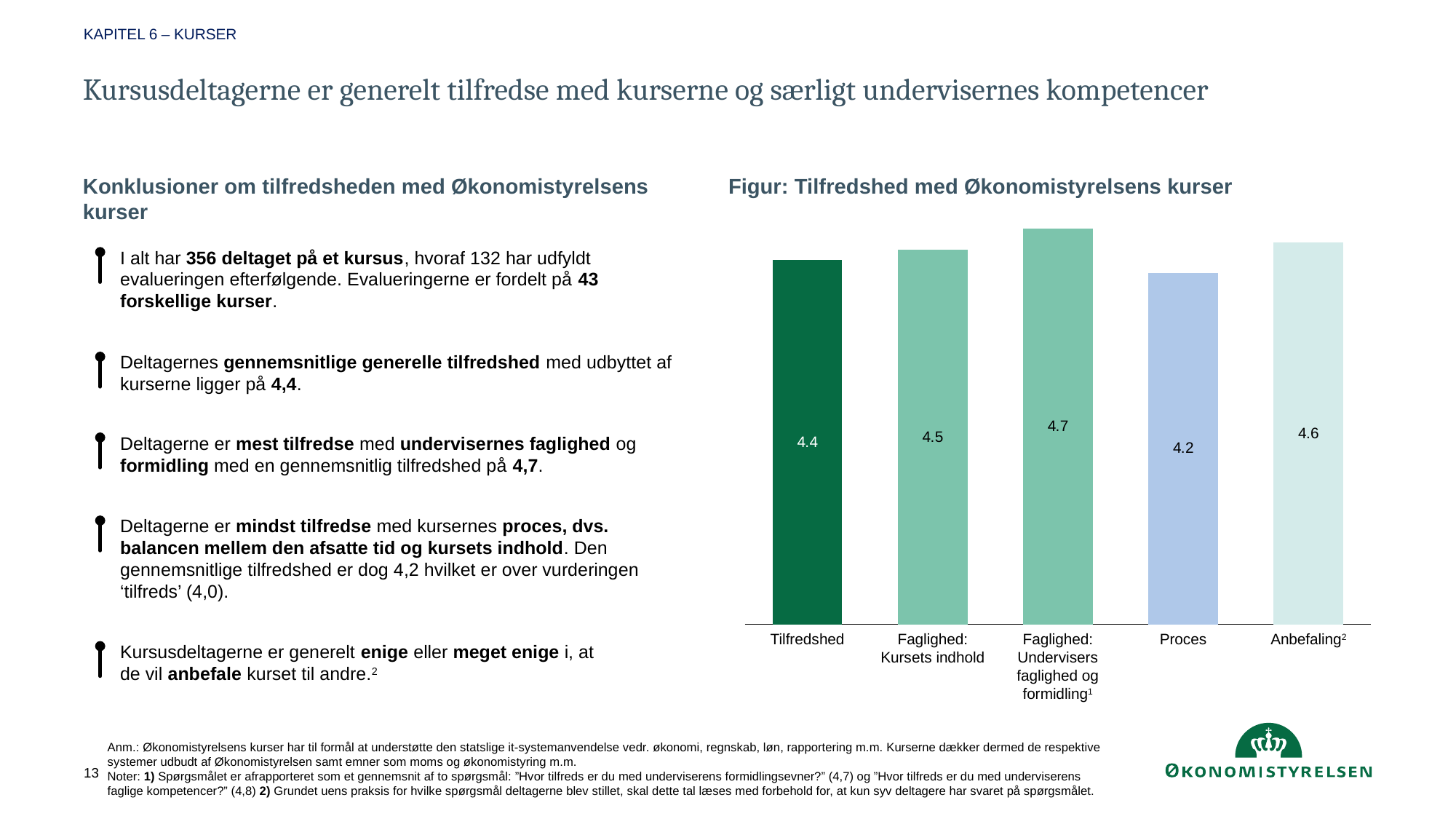
What is the value for Anbefaling in the chart? 4.6 What is the title of the chart? Figur: Tilfredshed med Økonomistyrelsens kurser What is the value for Tilfredshed in the chart? 4.4 What is the value for Proces in the chart? 4.2 Which category has the highest value in the chart? Faglighed: Undervisers faglighed og formidling How many categories are shown in the chart? 5 What kind of chart is shown on the slide? Bar chart Which is larger: the value for Anbefaling or the value for Tilfredshed? Anbefaling What is the difference between the value for Faglighed: Undervisers faglighed og formidling and the value for Proces? 0.5 What is the difference between the value for Faglighed: Kursets indhold and the value for Tilfredshed? 0.1 Which category has the lowest value in the chart? Proces What is the value for Faglighed: Kursets indhold? 4.5